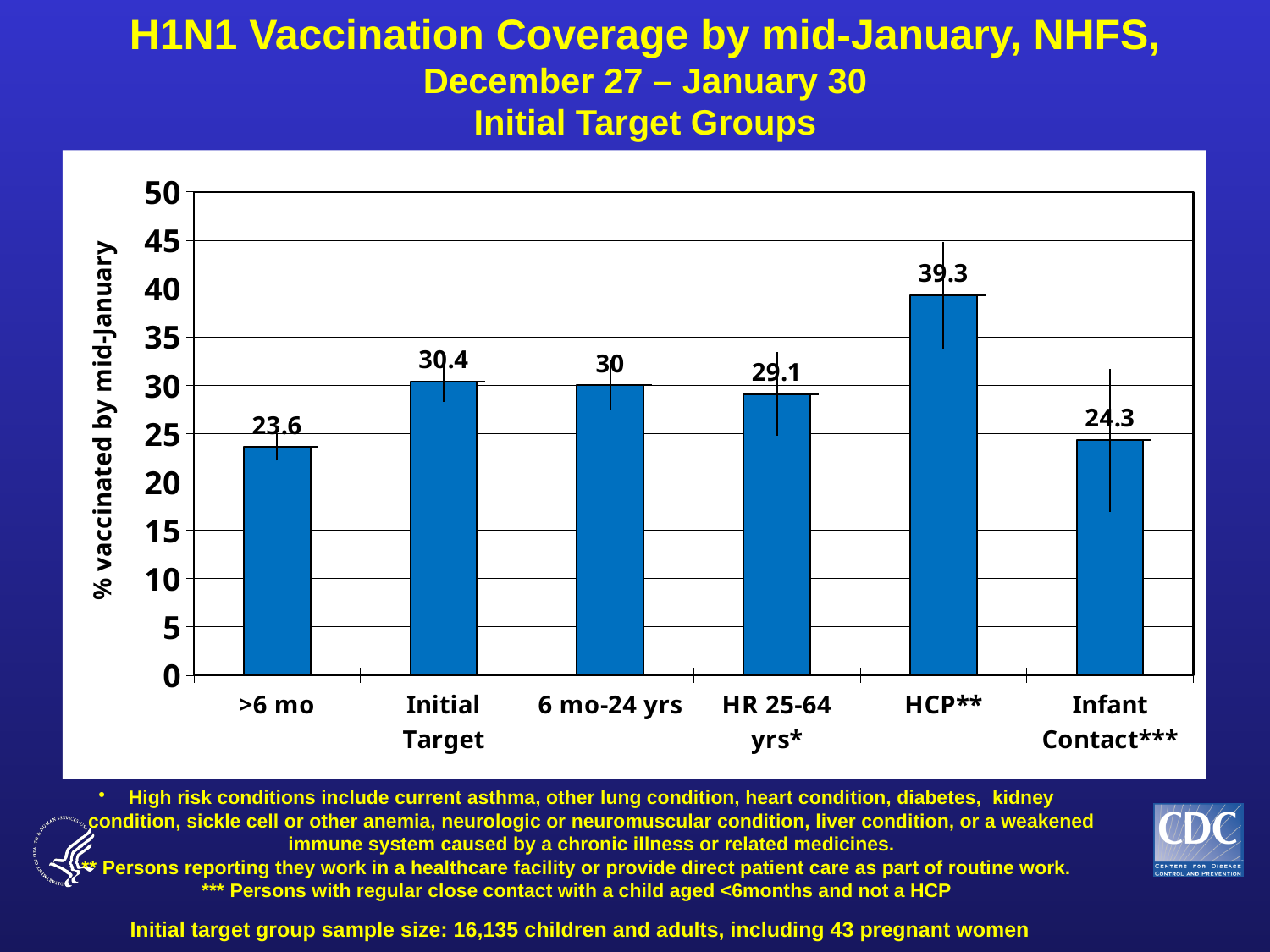
What kind of chart is shown on the slide? bar chart What is the % vaccinated by mid-January for HCP**? 39.3 What is the value for the Initial Target group? 30.4 What is the difference between the values for HCP** and HR 25-64 yrs*? 10.2 Which group has the highest % vaccinated by mid-January? HCP** Which is larger, the value for 6 mo-24 yrs or the value for Infant Contact***? 6 mo-24 yrs Which group has the lowest % vaccinated by mid-January? >6 mo Is the value for HCP** greater or less than 35? greater What is the label of the y axis? % vaccinated by mid-January How many groups are shown on the x axis? 6 What is the % vaccinated by mid-January for >6 mo? 23.6 What is the value for Infant Contact***? 24.3